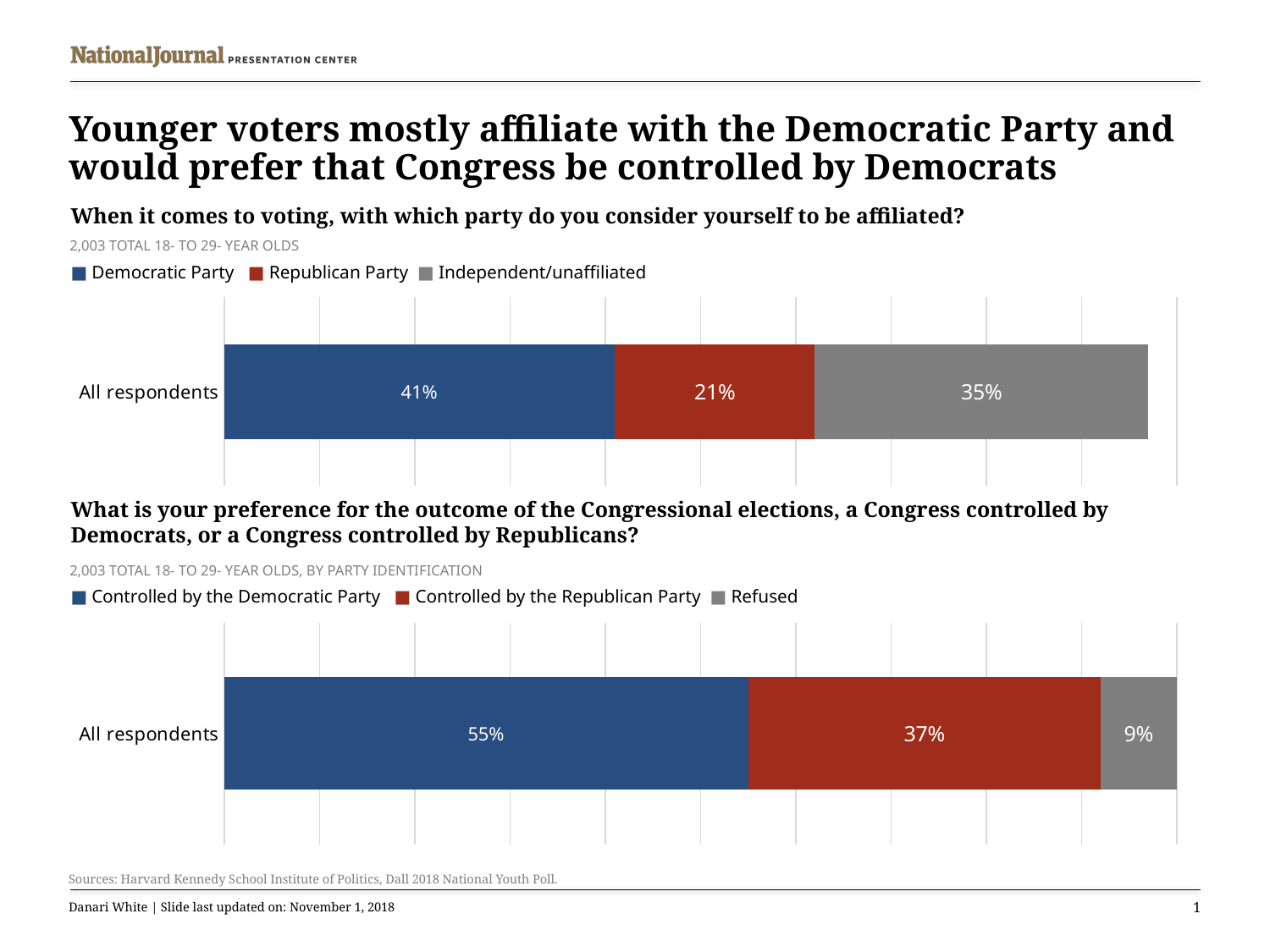
In the top chart on party affiliation, which series has the largest share? Democratic Party How many series does the legend of the bottom chart on Congressional election preference list? 3 What kind of chart is the top chart on party affiliation? Stacked bar chart In the bottom chart on Congressional election preference, what percentage prefer a Congress controlled by the Republican Party? 37% In the top chart on party affiliation, what percentage of respondents affiliate with the Democratic Party? 41% In the top chart on party affiliation, which series has the smallest share? Republican Party In the top chart on party affiliation, what is the difference in percentage points between the Democratic Party and Republican Party shares? 20 percentage points In the bottom chart on Congressional election preference, what percentage prefer a Congress controlled by the Democratic Party? 55% In the bottom chart on Congressional election preference, what percentage refused? 9% In the top chart on party affiliation, what percentage of respondents are Independent/unaffiliated? 35% In the bottom chart on Congressional election preference, what is the difference in percentage points between those preferring Democratic control and those preferring Republican control? 18 percentage points In the top chart on party affiliation, what percentage of respondents affiliate with the Republican Party? 21%